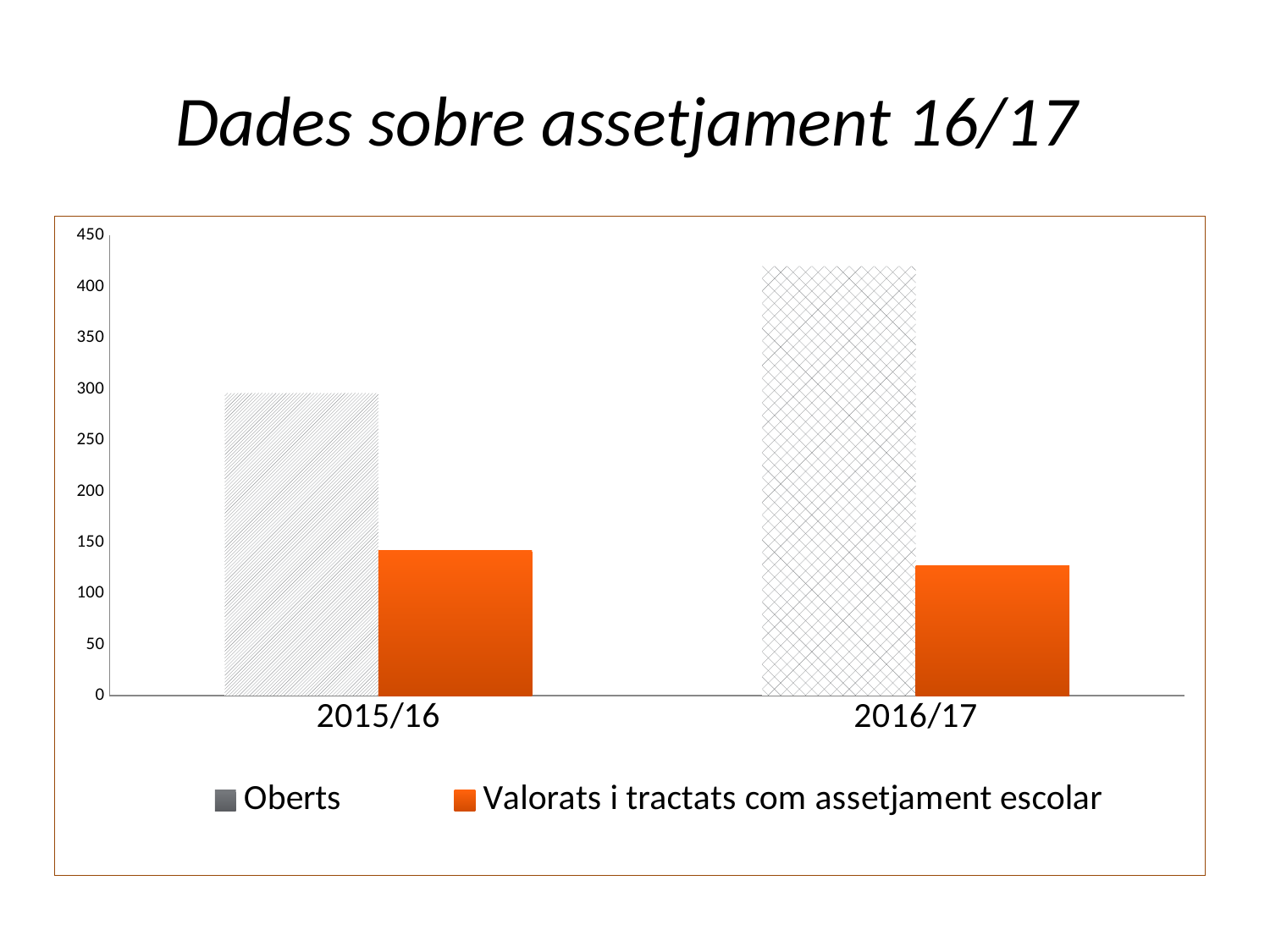
How many categories are shown on the x axis? 2 Which year has the higher value for Oberts, 2015/16 or 2016/17? 2016/17 What kind of chart is shown on the slide? bar chart Is the value for Valorats i tractats com assetjament escolar in 2015/16 greater or less than 100? greater How many series does the legend list? 2 Which year has the higher value for Valorats i tractats com assetjament escolar, 2015/16 or 2016/17? 2015/16 What is the title of the slide? Dades sobre assetjament 16/17 Is the value for Valorats i tractats com assetjament escolar in 2015/16 greater or less than 200? less Is the value for Oberts in 2016/17 greater or less than 400? greater Does the Oberts series rise or fall from 2015/16 to 2016/17? rise